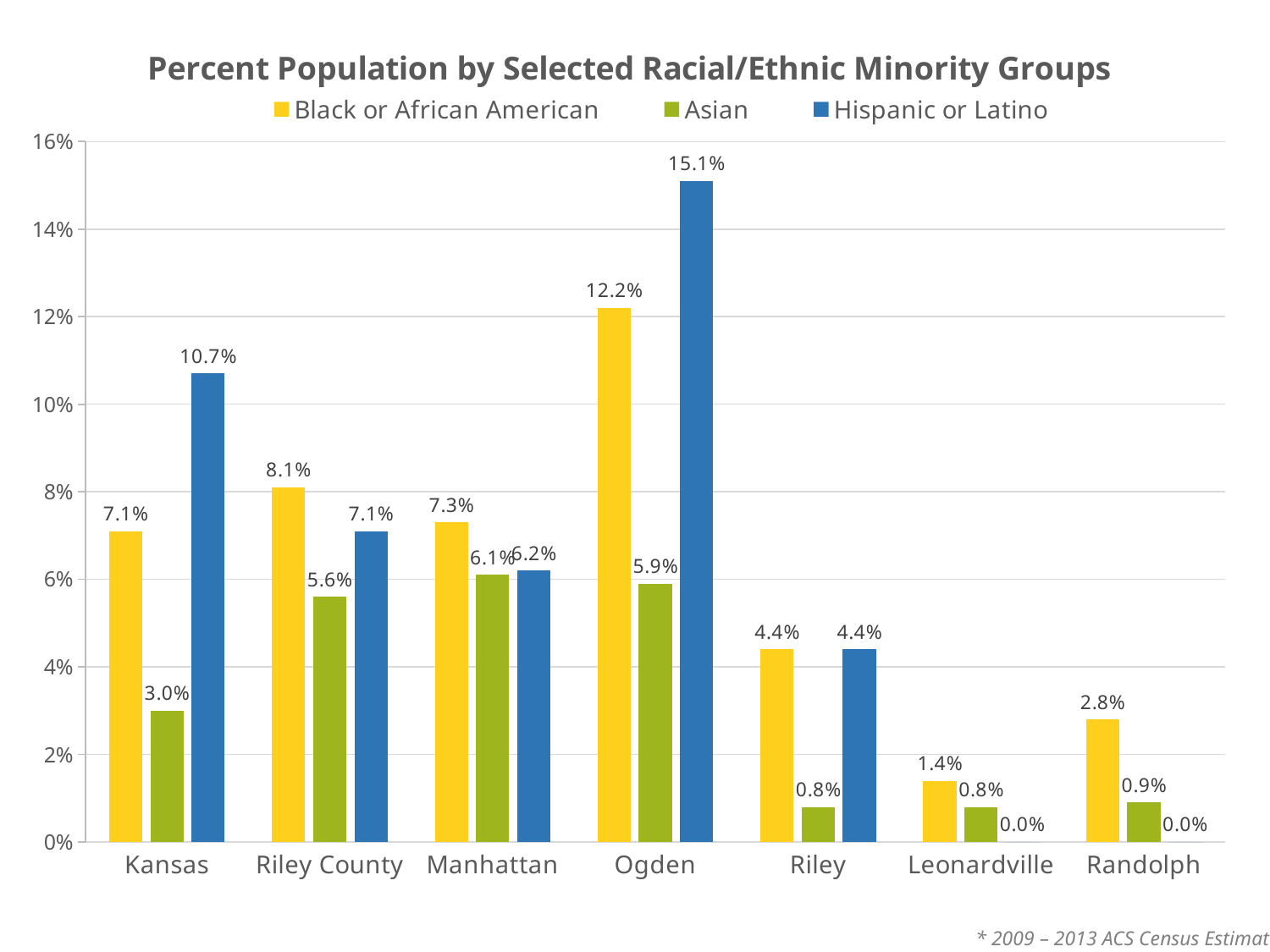
What is the title of the chart? Percent Population by Selected Racial/Ethnic Minority Groups Which is larger for Manhattan: the Black or African American percentage or the Asian percentage? Black or African American What is the Black or African American percentage for Riley County? 8.1% What is the Asian percentage for Kansas? 3.0% How many locations are shown on the x axis? 7 How many series does the legend list? 3 What is the difference between the Hispanic or Latino percentage for Kansas and for Riley County? 3.6% What kind of chart is shown on the slide? Bar chart Which location has the lowest Black or African American percentage? Leonardville What is the Hispanic or Latino percentage for Randolph? 0.0% What is the Hispanic or Latino percentage for Ogden? 15.1% Which location has the highest Black or African American percentage? Ogden